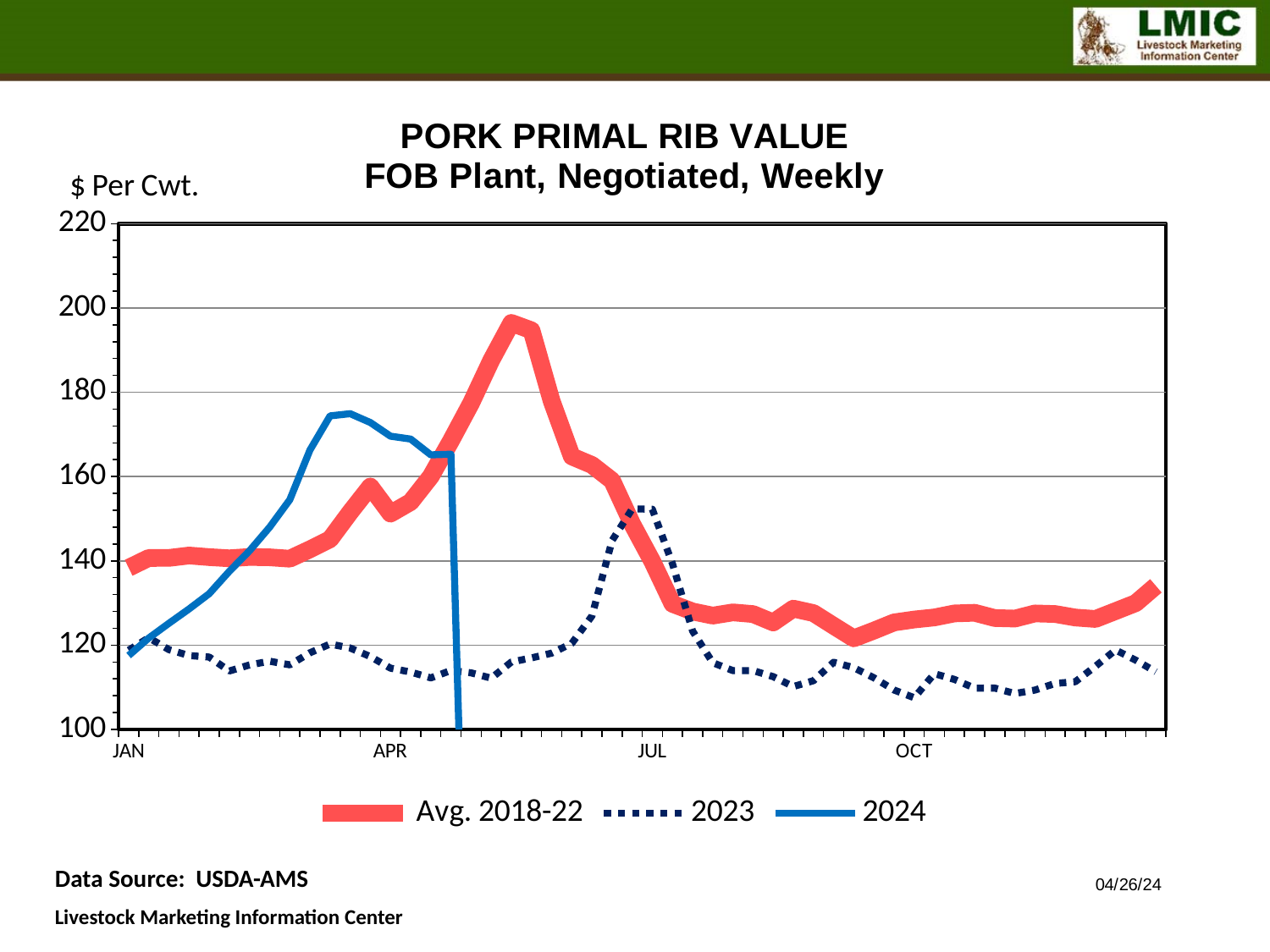
Is the peak value of the Avg. 2018-22 series greater or less than 180? greater Is the 2023 value at OCT greater or less than 120? less Does the 2024 series rise or fall from JAN to its peak before APR? rise What kind of chart is shown on the slide? line chart What unit is shown on the y axis? $ Per Cwt. Is the peak value of the 2024 series greater or less than 160? greater Which series reaches the highest value on the chart? Avg. 2018-22 At JAN, which series is higher, Avg. 2018-22 or 2023? Avg. 2018-22 How many series does the legend list? 3 What are the three series named in the legend? Avg. 2018-22, 2023, 2024